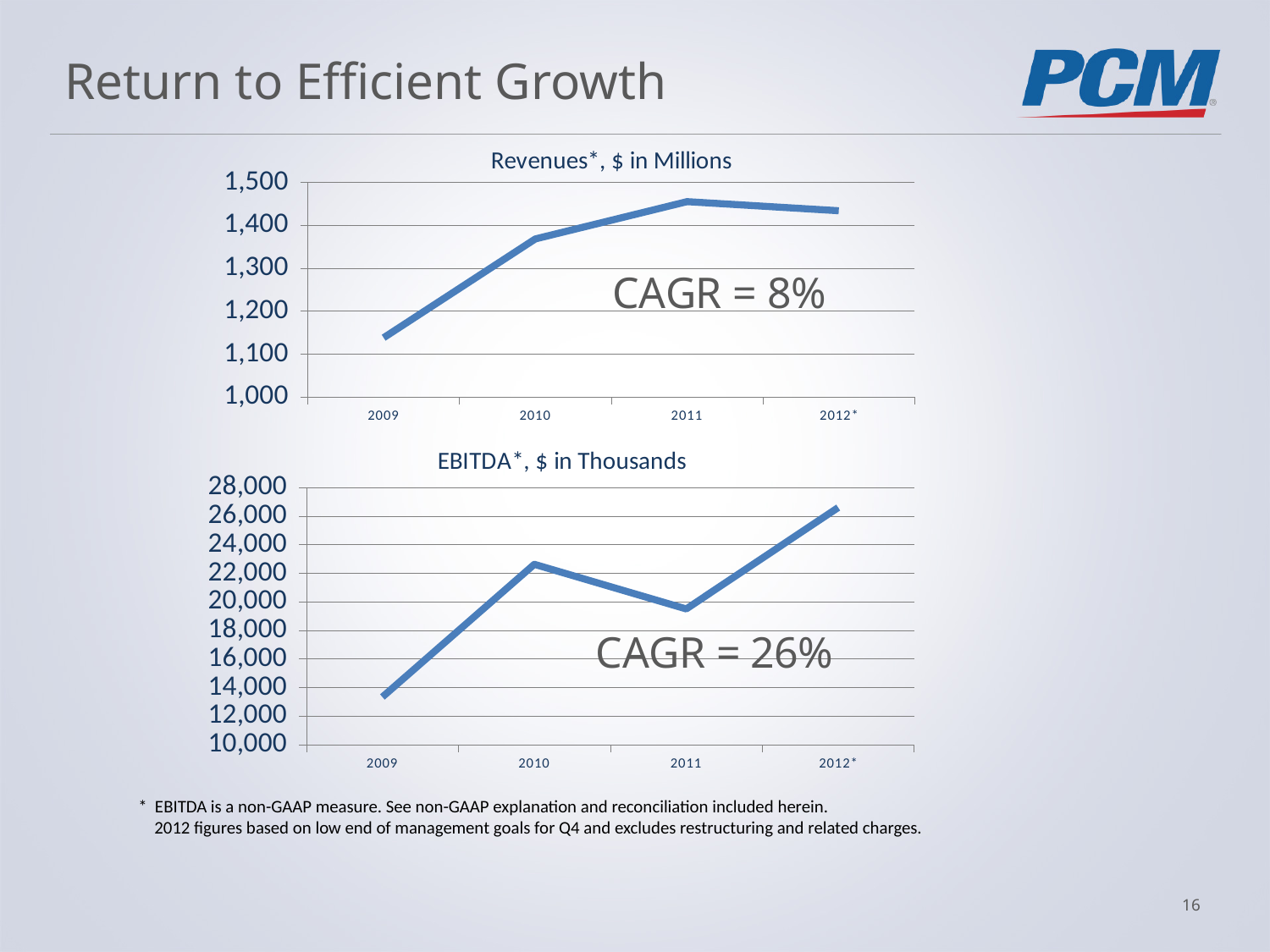
On the 'EBITDA*, $ in Thousands' chart, is the value for 2010 greater or less than 20,000? greater On the 'Revenues*, $ in Millions' chart, is the value for 2009 greater or less than 1,200? less On the 'EBITDA*, $ in Thousands' chart, which is larger, the value for 2010 or the value for 2011? 2010 On the 'Revenues*, $ in Millions' chart, which year has the highest revenue? 2011 What kind of chart is the 'Revenues*, $ in Millions' chart? line chart How many years are plotted on the 'EBITDA*, $ in Thousands' chart? 4 On the 'Revenues*, $ in Millions' chart, is the value for 2011 greater or less than 1,400? greater On the 'Revenues*, $ in Millions' chart, which year has the lowest revenue? 2009 On the 'EBITDA*, $ in Thousands' chart, which year has the lowest EBITDA? 2009 On the 'Revenues*, $ in Millions' chart, does revenue rise or fall from 2009 to 2011? rise What CAGR is shown on the 'EBITDA*, $ in Thousands' chart? 26% On the 'EBITDA*, $ in Thousands' chart, which year has the highest EBITDA? 2012*